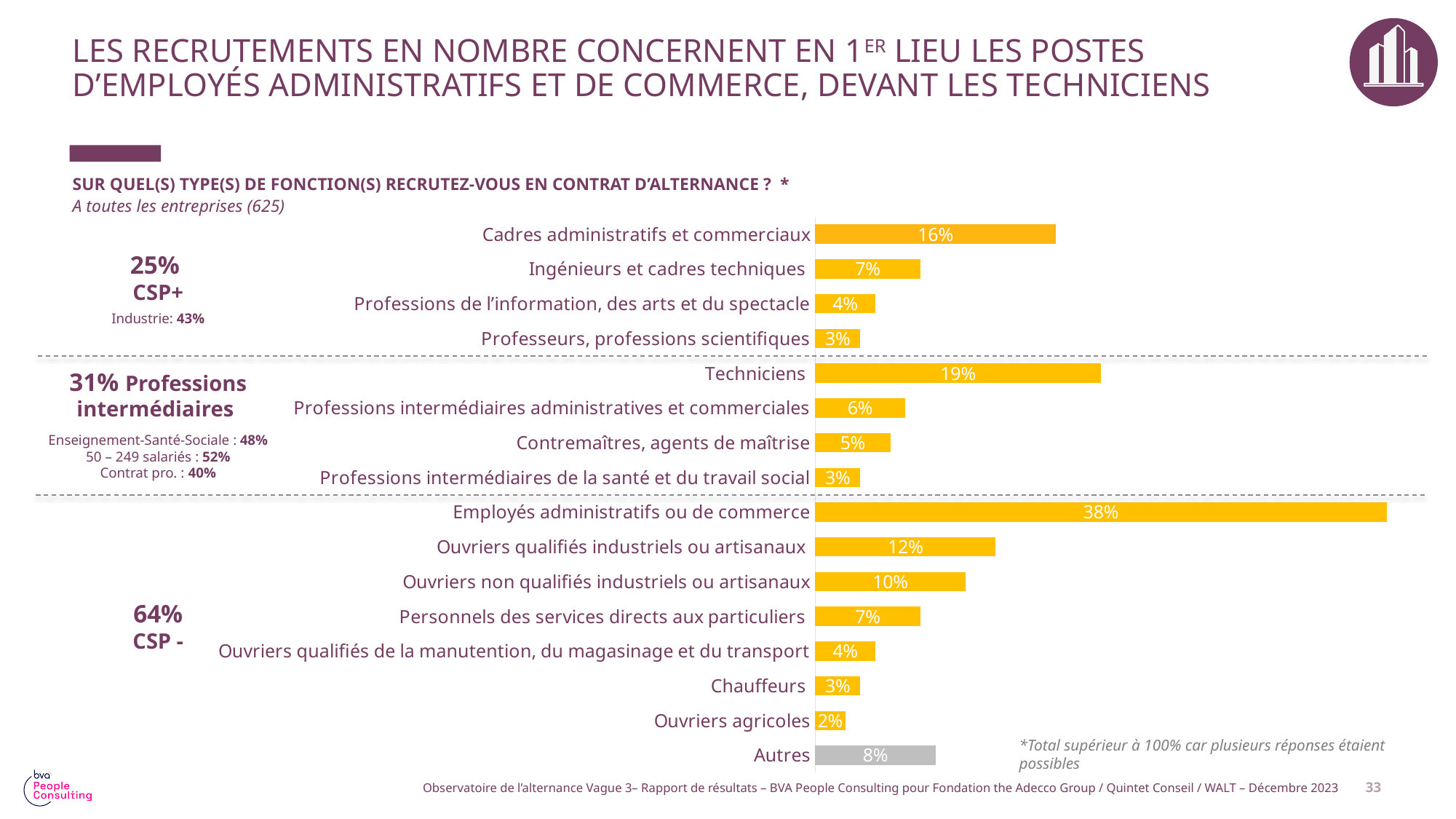
What is the value for Ouvriers non qualifiés industriels ou artisanaux? 10% What is the value for Autres? 8% What is the difference between the values for Ouvriers qualifiés industriels ou artisanaux and Ouvriers non qualifiés industriels ou artisanaux? 2% Which is larger, the value for Techniciens or the value for Cadres administratifs et commerciaux? Techniciens What kind of chart is shown on the slide? Bar chart What is the value for Techniciens? 19% What is the value for Employés administratifs ou de commerce? 38% How many categories are shown in the chart? 16 What is the difference between the values for Employés administratifs ou de commerce and Techniciens? 19% Which category has the highest value? Employés administratifs ou de commerce Which category has the lowest value? Ouvriers agricoles What is the value for Cadres administratifs et commerciaux? 16%